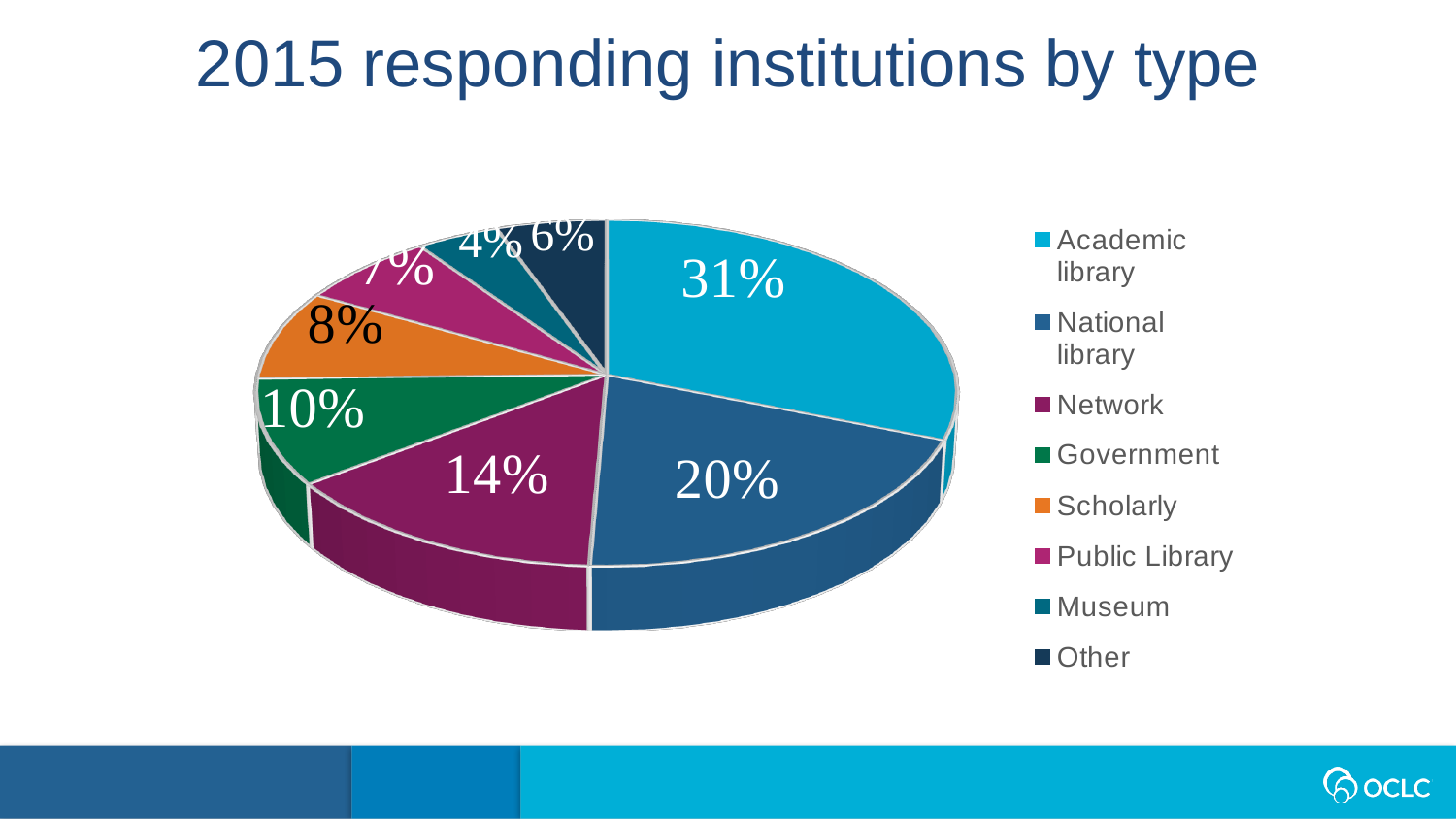
What percentage of the pie is Museum? 4% What percentage of the pie is Scholarly? 8% What share of responding institutions are National libraries? 20% Which institution type has the largest slice of the pie? Academic library What kind of chart is shown on the slide? pie chart What is the difference in percentage points between Academic library and National library? 11 How many institution types does the legend list? 8 Which institution type has the smallest slice of the pie? Museum Which is larger, the Government slice or the Other slice? Government